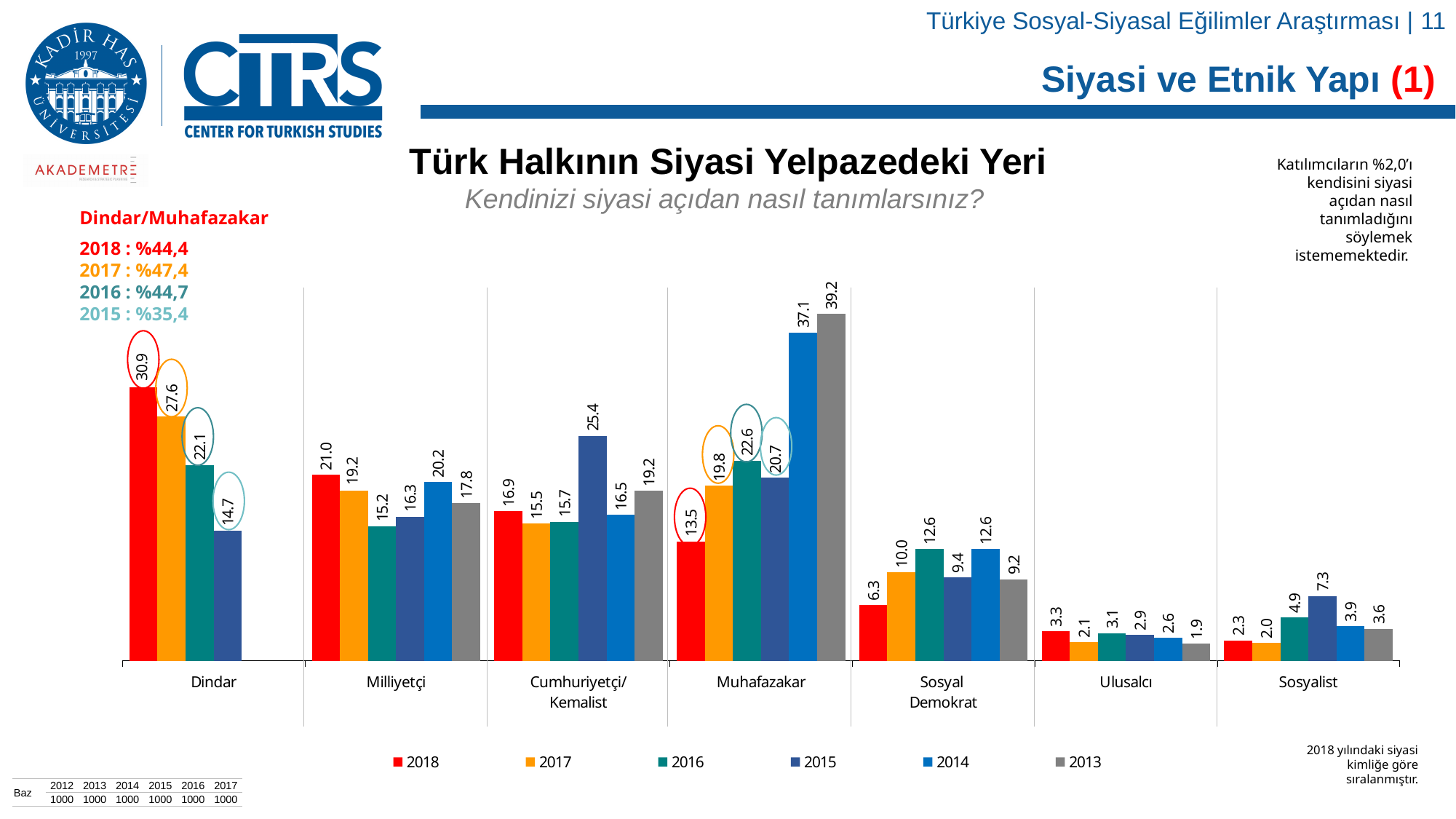
Which category has the lowest 2017 value? Sosyalist What is the 2015 value for Cumhuriyetçi/Kemalist? 25.4 Which is larger for Muhafazakar: the 2014 value or the 2016 value? 2014 How many categories are shown on the x axis? 7 What kind of chart is shown? Bar chart What is the 2016 value for Sosyalist? 4.9 What is the difference between the 2018 and 2017 values for Dindar? 3.3 What is the 2013 value for Muhafazakar? 39.2 How many series does the legend list? 6 What is the 2018 value for Dindar? 30.9 What is the difference between the 2013 and 2018 values for Muhafazakar? 25.7 Which category has the highest 2018 value? Dindar